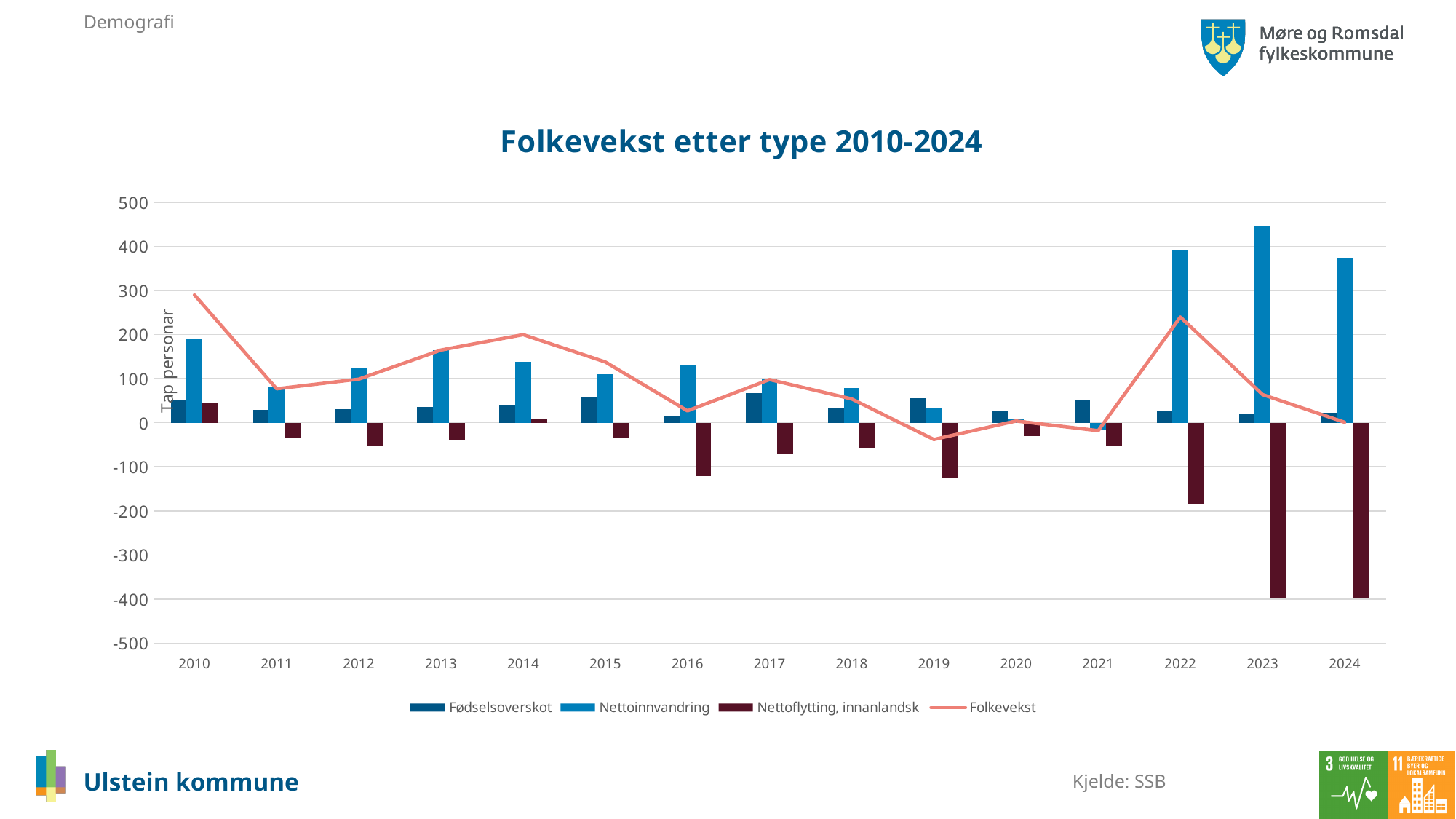
Which is larger, the Fødselsoverskot value for 2016 or for 2017? 2017 In which year does the Folkevekst line reach its highest point? 2010 What is the title of the chart? Folkevekst etter type 2010-2024 Which series is drawn as a line rather than bars? Folkevekst Does the Folkevekst line rise or fall from 2022 to 2024? fall Is the Nettoinnvandring value for 2023 greater or less than 400? greater In which year is the Nettoinnvandring bar highest? 2023 Is the Nettoflytting, innanlandsk value for 2022 greater or less than -100? less How many series does the legend list? 4 How many years are shown on the x axis? 15 What kind of chart is shown on the slide? A combined bar and line chart Is the Folkevekst value for 2014 greater or less than 100? greater